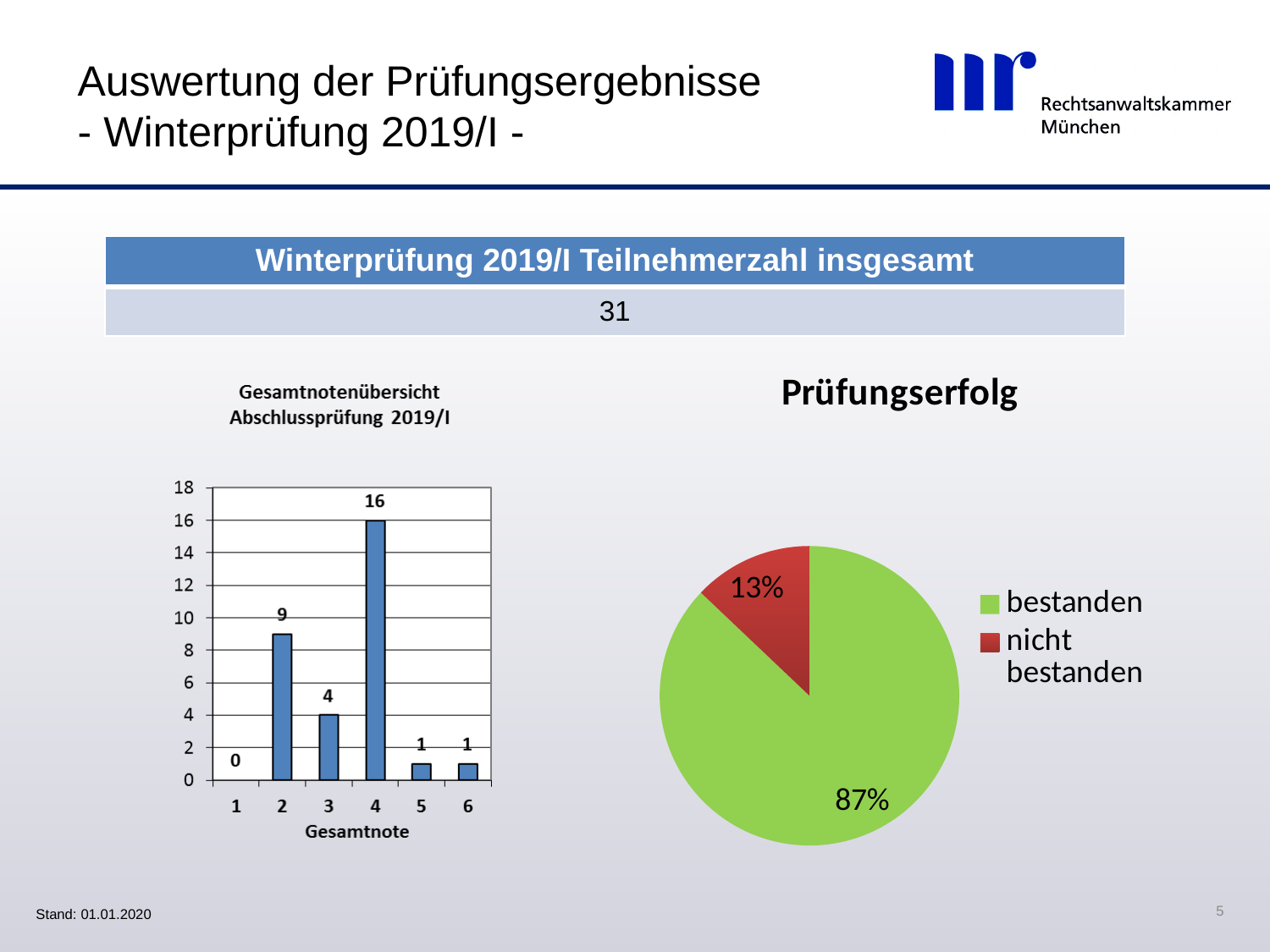
What kind of chart is 'Gesamtnotenübersicht Abschlussprüfung 2019/I'? bar chart In the bar chart 'Gesamtnotenübersicht Abschlussprüfung 2019/I', what is the value for Gesamtnote 4? 16 In the pie chart 'Prüfungserfolg', what colour is the 'nicht bestanden' slice? red In the pie chart 'Prüfungserfolg', what share is 'nicht bestanden'? 13% In the pie chart 'Prüfungserfolg', what share is 'bestanden'? 87% In the bar chart 'Gesamtnotenübersicht Abschlussprüfung 2019/I', what is the difference between the values for Gesamtnote 4 and Gesamtnote 2? 7 In the bar chart 'Gesamtnotenübersicht Abschlussprüfung 2019/I', which Gesamtnote has the highest value? 4 In the bar chart 'Gesamtnotenübersicht Abschlussprüfung 2019/I', which Gesamtnote has the lowest value? 1 In the bar chart 'Gesamtnotenübersicht Abschlussprüfung 2019/I', how many Gesamtnote categories are shown on the x axis? 6 In the bar chart 'Gesamtnotenübersicht Abschlussprüfung 2019/I', which is larger: the value for Gesamtnote 2 or Gesamtnote 3? Gesamtnote 2 How many entries does the legend of the pie chart 'Prüfungserfolg' list? 2 In the bar chart 'Gesamtnotenübersicht Abschlussprüfung 2019/I', what is the value for Gesamtnote 2? 9